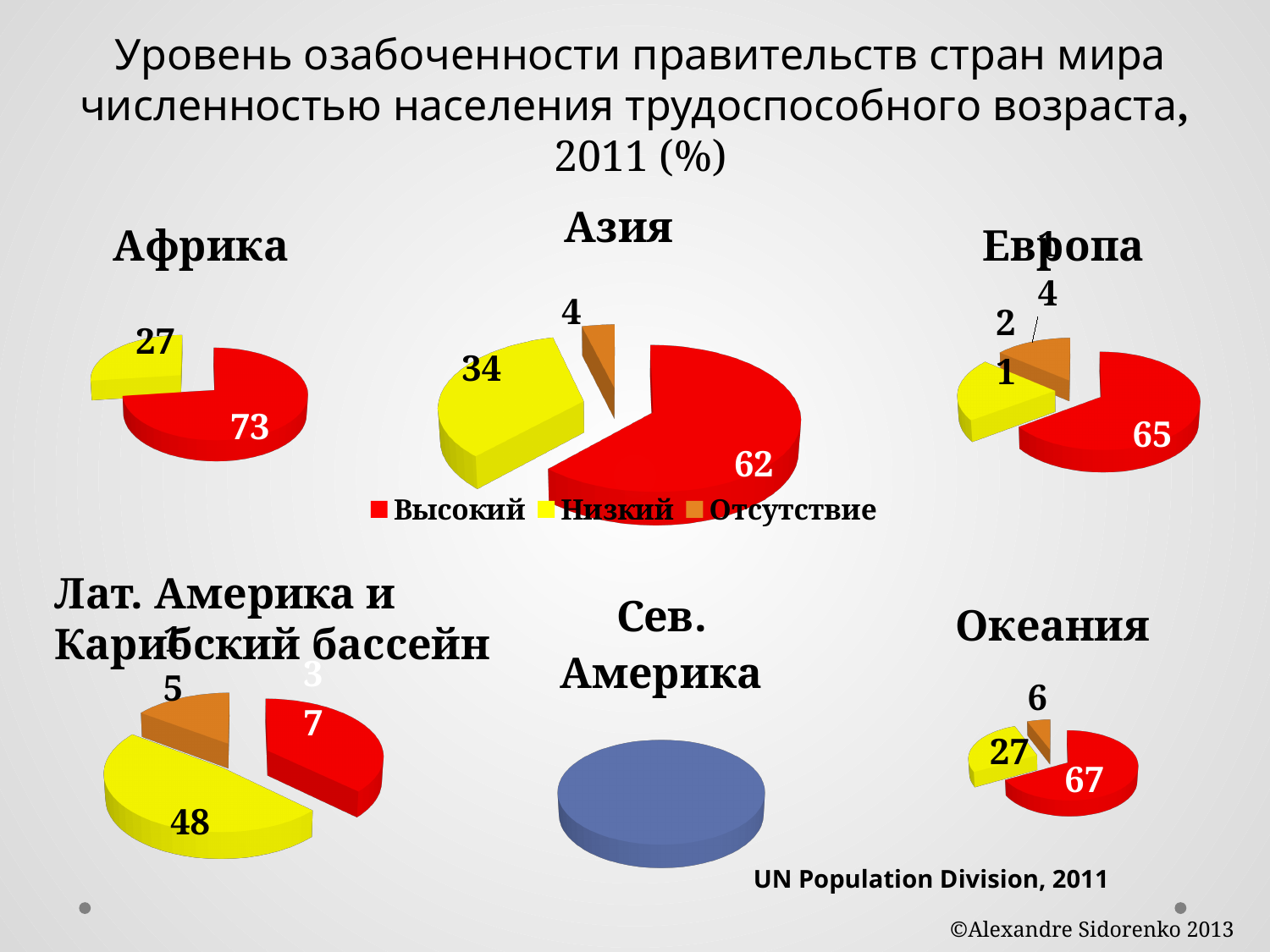
On the Африка chart, what is the value for Низкий? 27 On the Африка chart, what is the value for Высокий? 73 On the Лат. Америка и Карибский бассейн chart, what is the value for Низкий? 48 On the Океания chart, what is the value for Высокий? 67 Which is larger on the Африка chart: Высокий or Низкий? Высокий On the Океания chart, which category has the smallest slice? Отсутствие On the Азия chart, which category has the largest slice? Высокий How many series does the legend list? 3 On the Европа chart, what is the value for Высокий? 65 On the Азия chart, what is the value for Отсутствие? 4 On the Азия chart, what is the difference between Высокий and Низкий? 28 On the Азия chart, what is the value for Низкий? 34